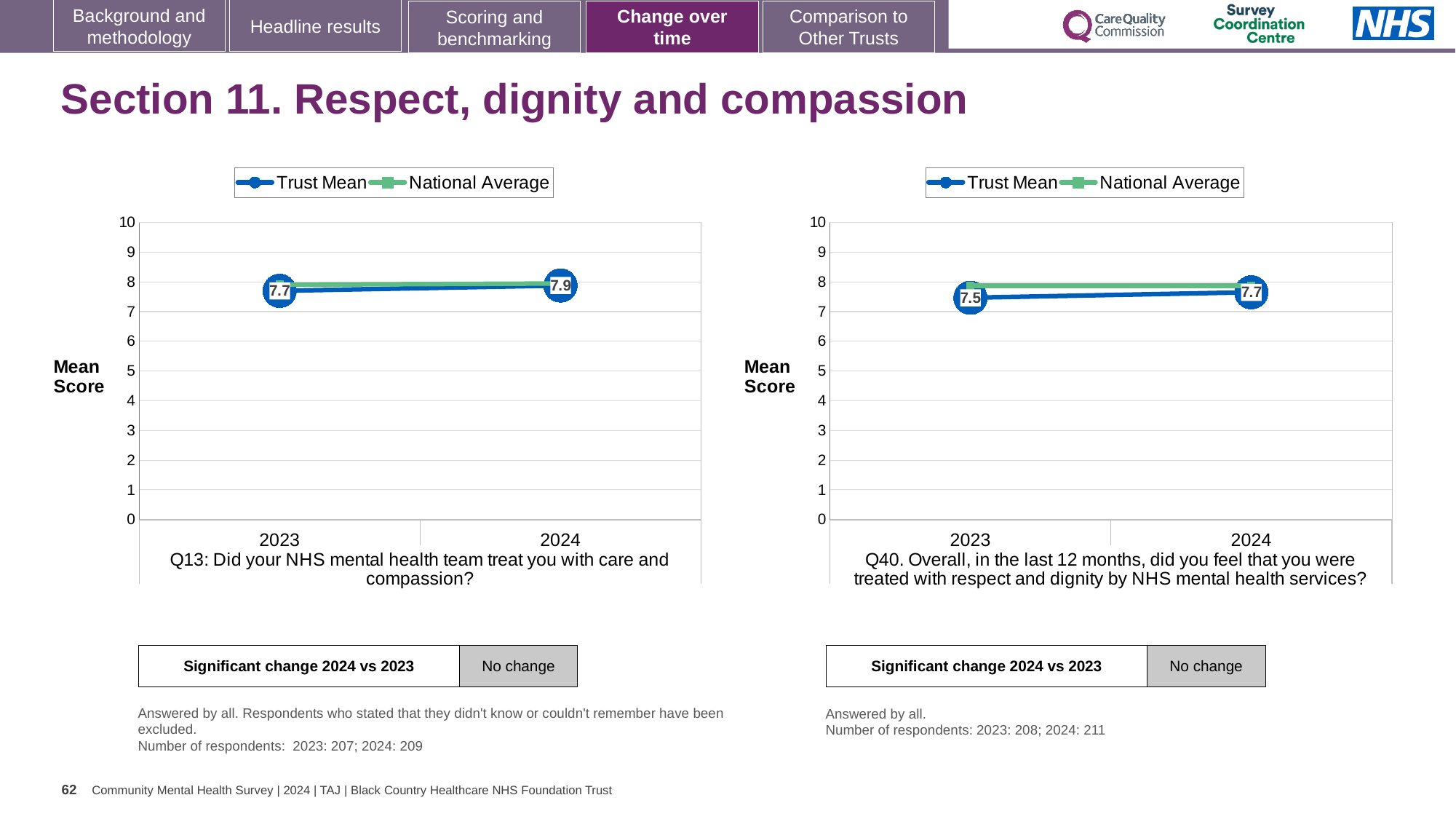
What kind of chart is the Q40 chart (right)? line chart In the Q40 chart (right), is the National Average for 2023 greater or less than 7? greater In the Q40 chart (right), what is the Trust Mean for 2024? 7.7 In the Q13 chart (left), by how much did the Trust Mean change from 2023 to 2024? 0.2 In the Q13 chart (left), which year has the higher Trust Mean, 2023 or 2024? 2024 In the Q13 chart (left), what is the Trust Mean for 2023? 7.7 In the Q40 chart (right), what is the Trust Mean for 2023? 7.5 In the Q40 chart (right), does the Trust Mean rise or fall from 2023 to 2024? rise In the Q40 chart (right), what is the difference between the Trust Mean in 2024 and in 2023? 0.2 In the Q13 chart (left), what is the Trust Mean for 2024? 7.9 Which is larger: the 2023 Trust Mean in the Q13 chart (left) or the 2023 Trust Mean in the Q40 chart (right)? Q13 chart (left) How many series does the legend of the Q13 chart (left) list? 2